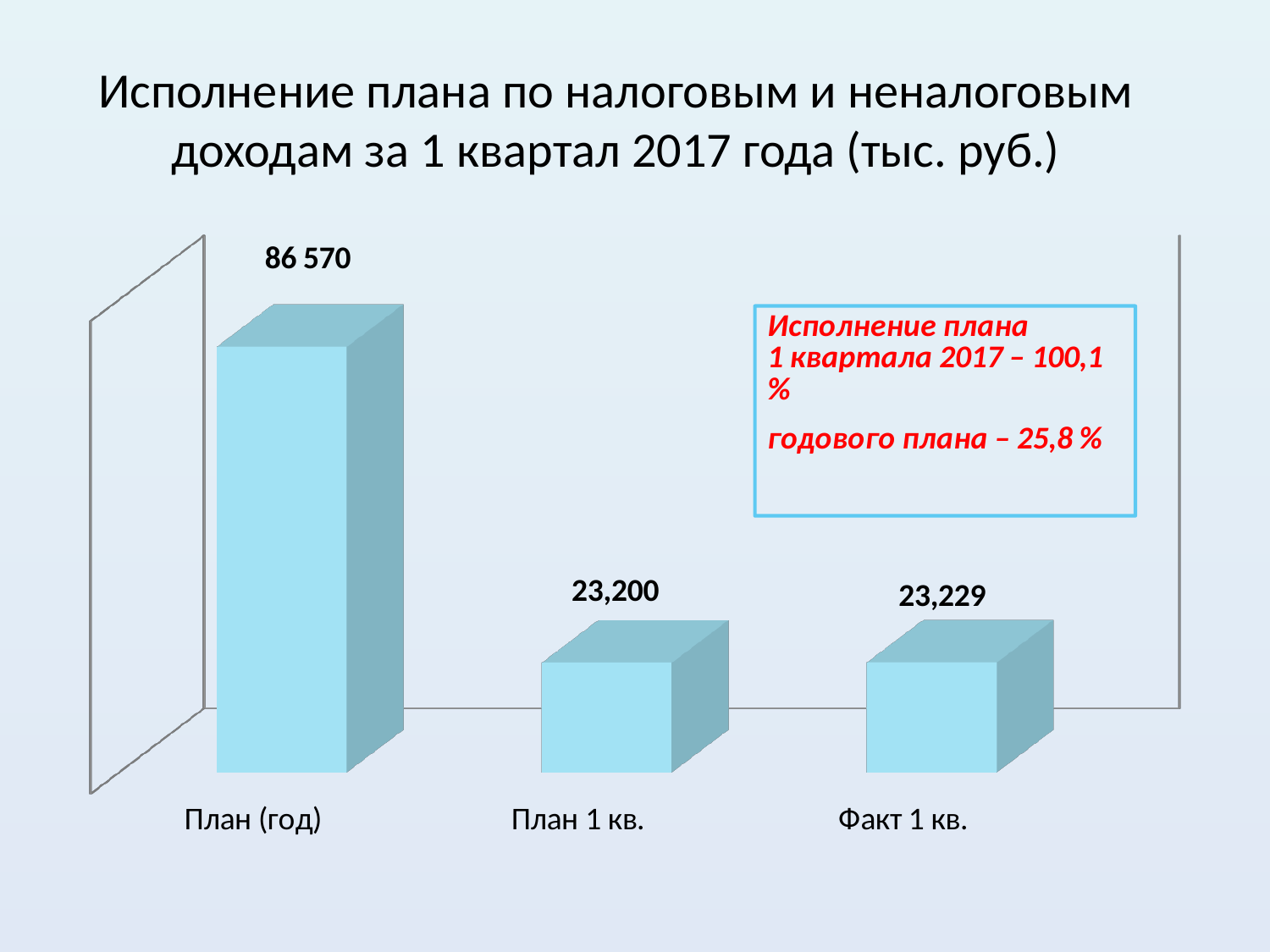
What is the difference between the values for Факт 1 кв. and План 1 кв.? 29 What is the value for План 1 кв.? 23,200 What is the value for План (год)? 86 570 According to the text box on the slide, what percentage of the annual plan was fulfilled? 25,8 % What kind of chart is shown on the slide? bar chart How many categories are shown in the chart? 3 Which category has the highest value? План (год) Is the value for План (год) larger or smaller than the value for Факт 1 кв.? larger What is the title of the chart? Исполнение плана по налоговым и неналоговым доходам за 1 квартал 2017 года (тыс. руб.) What is the value for Факт 1 кв.? 23,229